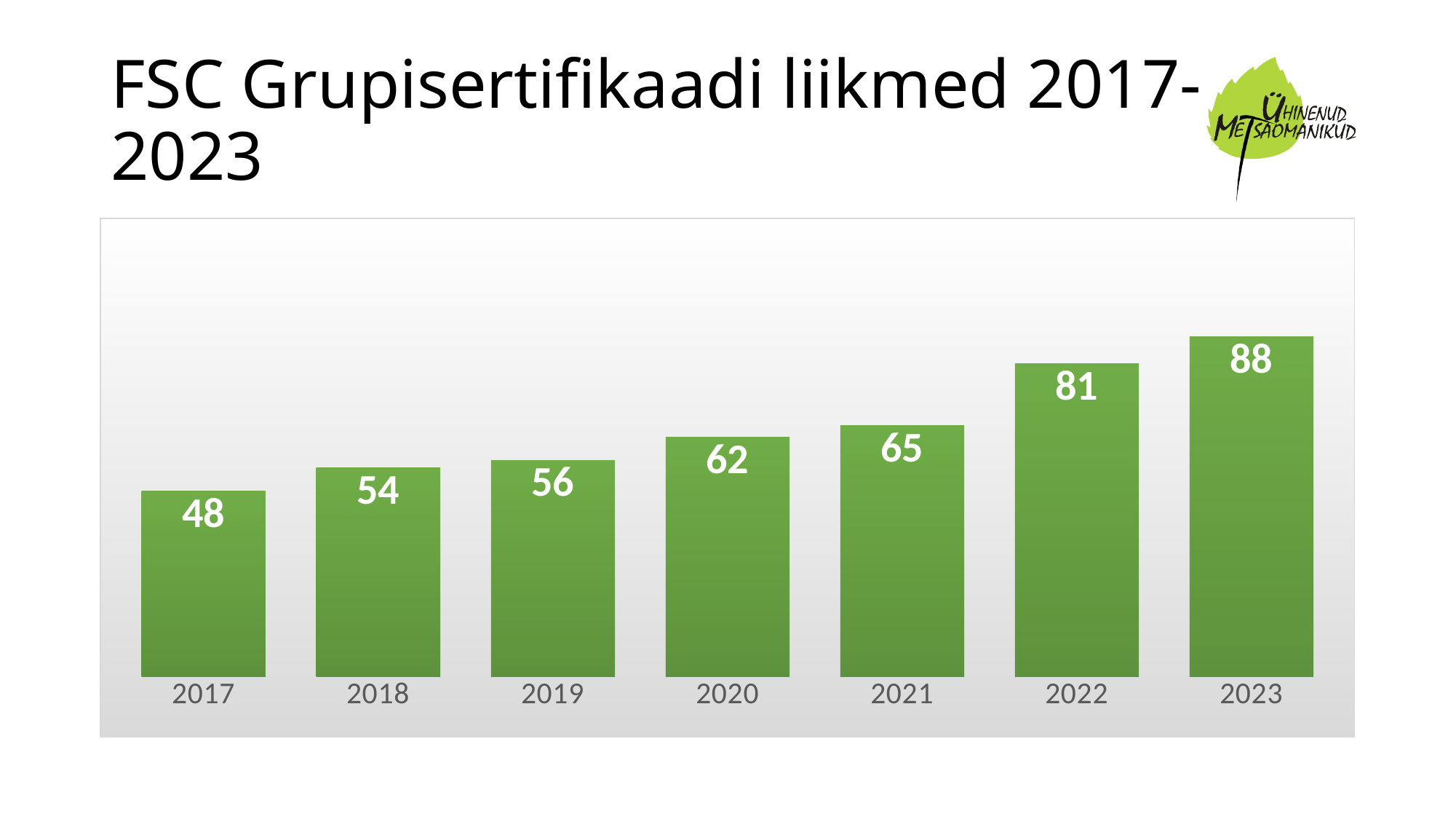
Which year has the lowest value? 2017 What is the difference between the values for 2022 and 2021? 16 Which year has the highest value? 2023 Which is larger, the value for 2019 or the value for 2021? 2021 What is the difference between the values for 2023 and 2017? 40 Do the values rise or fall from 2017 to 2023? rise What is the title of the slide? FSC Grupisertifikaadi liikmed 2017-2023 What is the value for 2022? 81 What kind of chart is shown on the slide? bar chart How many years are shown on the x axis? 7 What is the value for 2017? 48 What is the value for 2020? 62